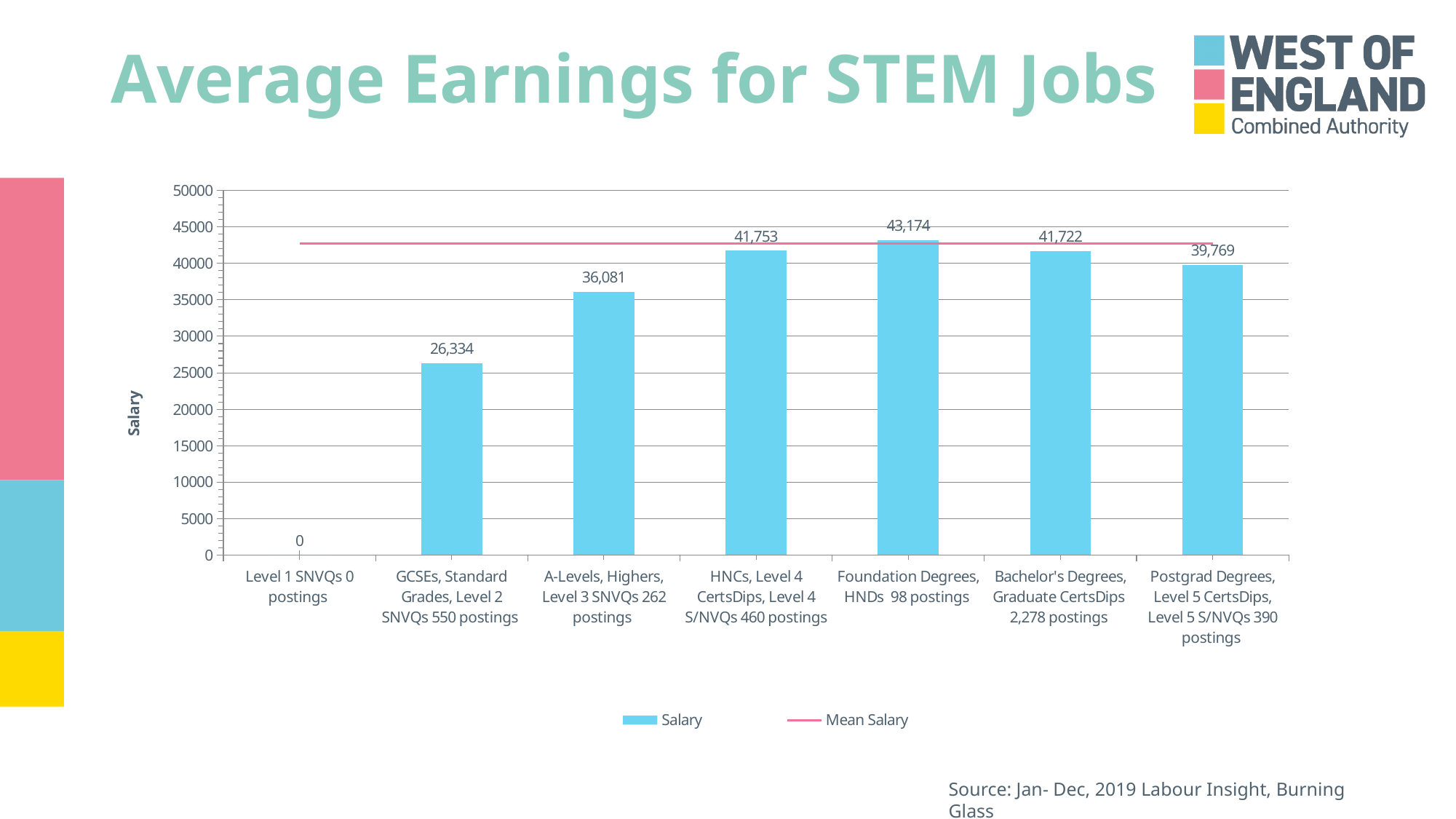
Which has the larger salary: Bachelor's Degrees, Graduate CertsDips 2,278 postings or Postgrad Degrees, Level 5 CertsDips, Level 5 S/NVQs 390 postings? Bachelor's Degrees, Graduate CertsDips 2,278 postings What is the difference in salary between Foundation Degrees, HNDs 98 postings and HNCs, Level 4 CertsDips, Level 4 S/NVQs 460 postings? 1,421 How many categories are shown on the x axis? 7 What is the salary value for Postgrad Degrees, Level 5 CertsDips, Level 5 S/NVQs 390 postings? 39,769 What is the salary value for HNCs, Level 4 CertsDips, Level 4 S/NVQs 460 postings? 41,753 What is the salary value for GCSEs, Standard Grades, Level 2 SNVQs 550 postings? 26,334 Which category has the highest salary? Foundation Degrees, HNDs 98 postings What kind of chart is shown on the slide? combination bar and line chart How many series does the legend list? 2 What is the difference in salary between A-Levels, Highers, Level 3 SNVQs 262 postings and GCSEs, Standard Grades, Level 2 SNVQs 550 postings? 9,747 Which category has the lowest salary? Level 1 SNVQs 0 postings Is the Mean Salary line greater or less than 40000? greater